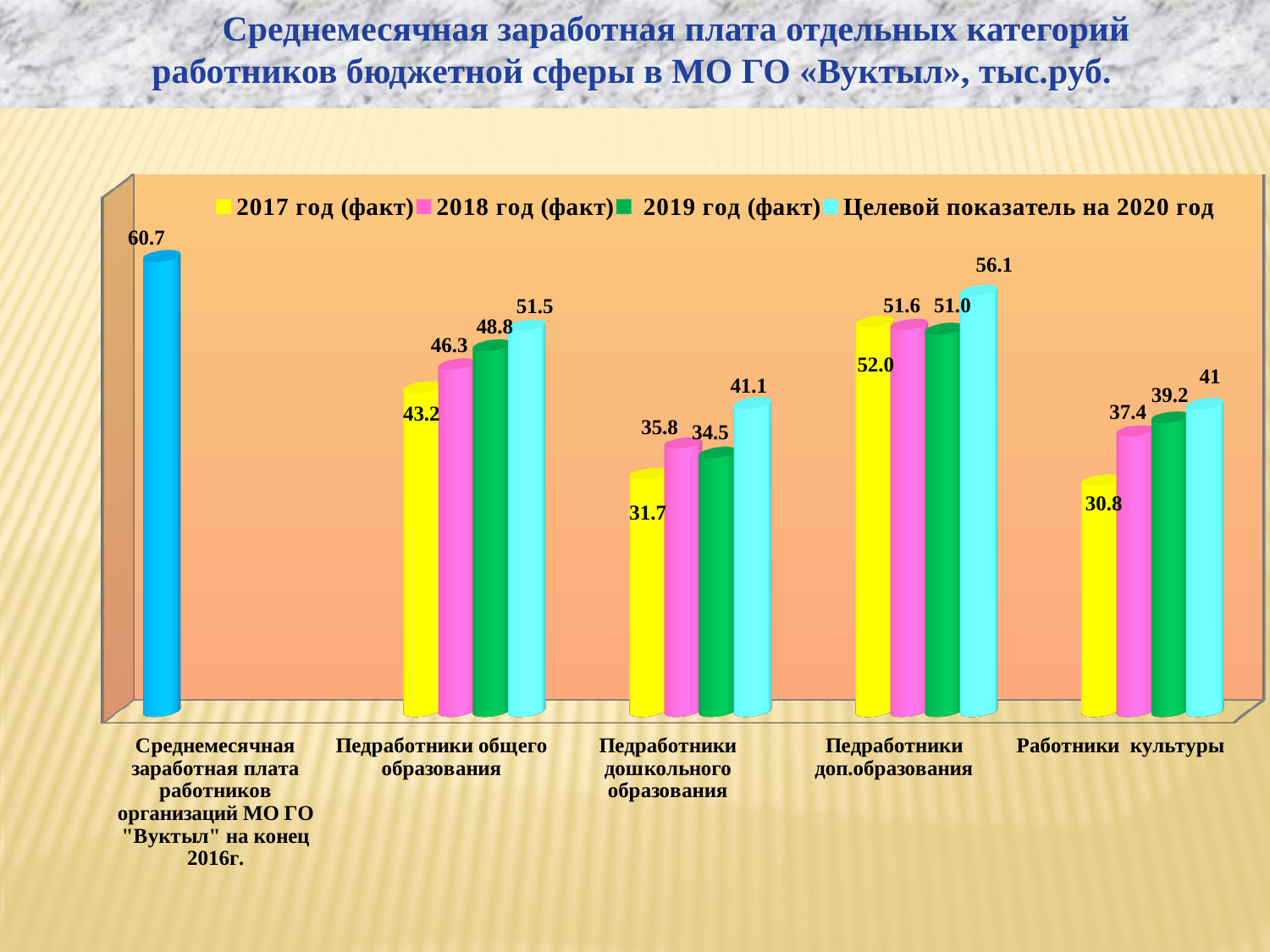
What is the value shown for Среднемесячная заработная плата работников организаций МО ГО "Вуктыл" на конец 2016г.? 60.7 What kind of chart is shown on the slide? Bar chart How many series does the legend list? 4 What is the difference between the Целевой показатель на 2020 год and the 2017 год (факт) values for Педработники общего образования? 8.3 What is the Целевой показатель на 2020 год value for Педработники доп.образования? 56.1 How many categories are shown on the x axis? 5 Which is larger for Педработники дошкольного образования: the 2018 год (факт) value or the 2019 год (факт) value? 2018 год (факт) Do the values for Работники культуры rise or fall from 2017 год (факт) to Целевой показатель на 2020 год? Rise Among the four series for Педработники дошкольного образования, which has the highest value? Целевой показатель на 2020 год What is the 2019 год (факт) value for Работники культуры? 39.2 Which category has the lowest 2017 год (факт) value? Работники культуры What is the 2017 год (факт) value for Педработники общего образования? 43.2